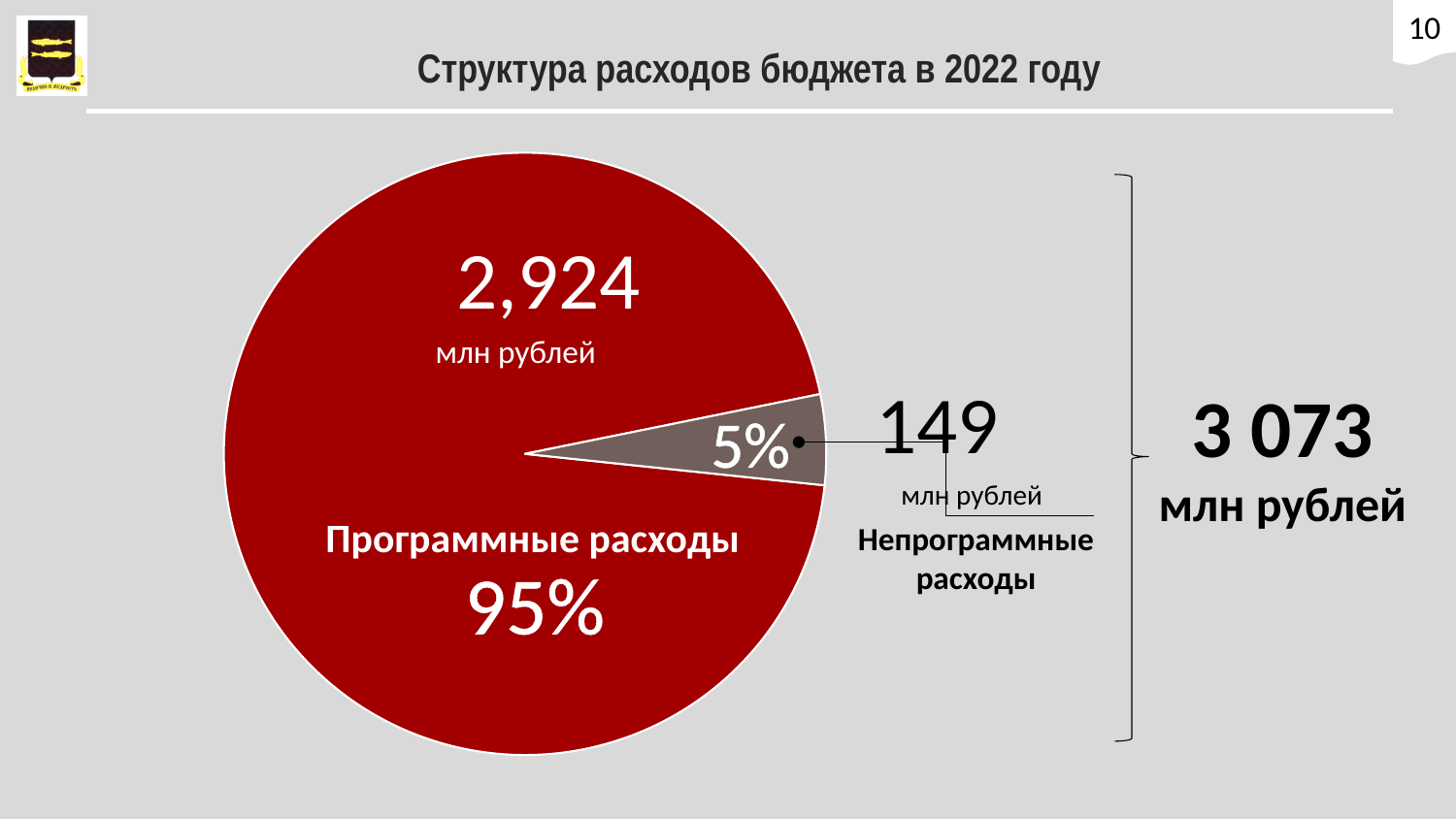
Which is larger, Программные расходы or Непрограммные расходы? Программные расходы What share of the pie does Непрограммные расходы take? 5% How many categories are shown in the pie chart? 2 What is the difference in млн рублей between Программные расходы and Непрограммные расходы? 2,775 What is the value for Программные расходы in млн рублей? 2,924 What total in млн рублей is shown next to the bracket on the right of the chart? 3 073 What share of the pie does Программные расходы take? 95% What is the value for Непрограммные расходы in млн рублей? 149 Which category has the smallest slice of the pie? Непрограммные расходы Which category has the largest slice of the pie? Программные расходы What type of chart is shown on the slide? Pie chart What is the title of the slide? Структура расходов бюджета в 2022 году